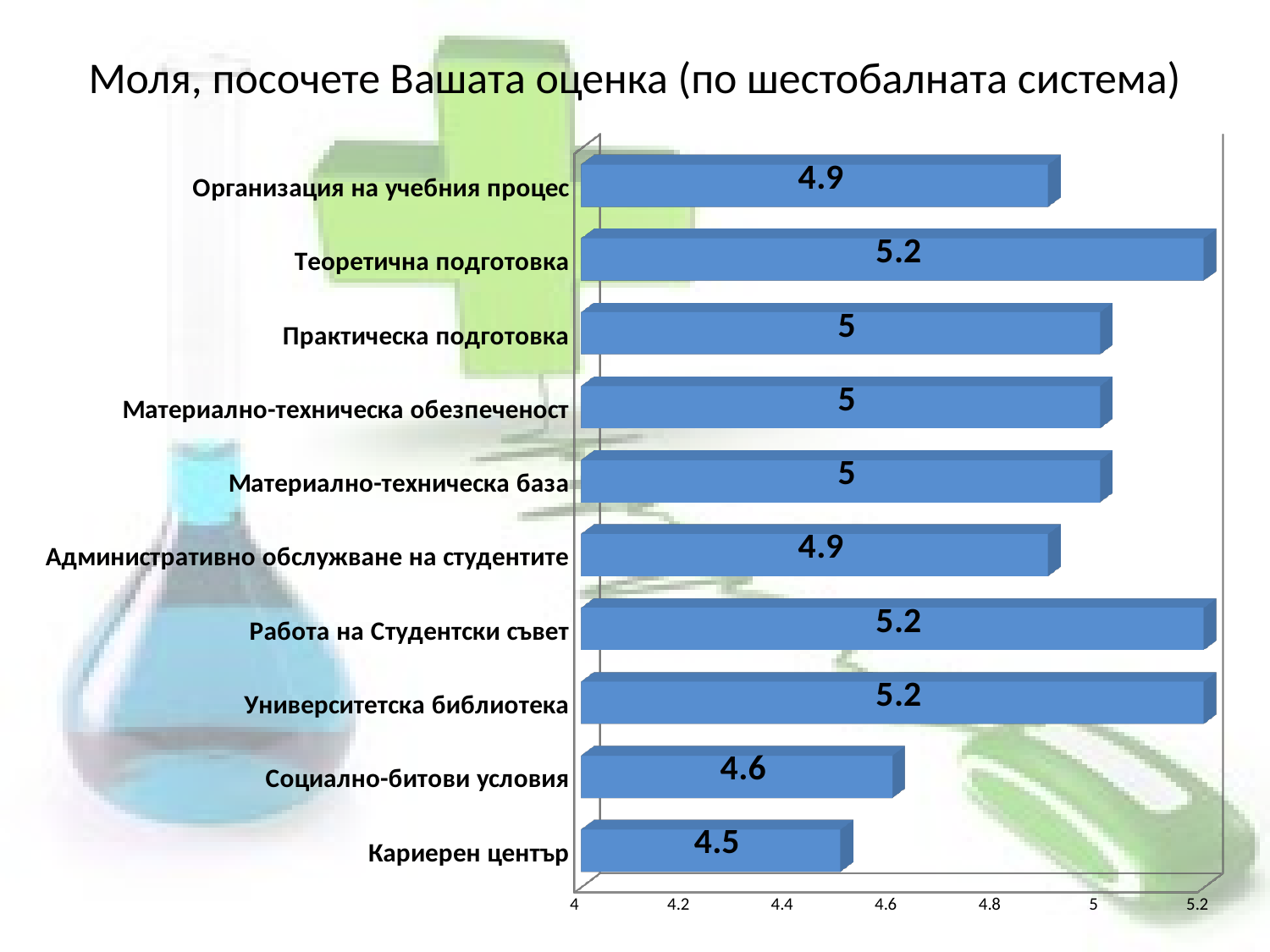
What is the difference between the values for Университетска библиотека and Кариерен център? 0.7 What is the value for Организация на учебния процес? 4.9 How many categories are shown in the chart? 10 What is the value for Социално-битови условия? 4.6 What is the title of the slide? Моля, посочете Вашата оценка (по шестобалната система) What is the value for Кариерен център? 4.5 What is the value for Теоретична подготовка? 5.2 What kind of chart is shown on the slide? bar chart What is the value for Материално-техническа база? 5 Which category has the lowest value? Кариерен център Is the value for Социално-битови условия greater or less than 5? less Which is larger, the value for Работа на Студентски съвет or the value for Социално-битови условия? Работа на Студентски съвет